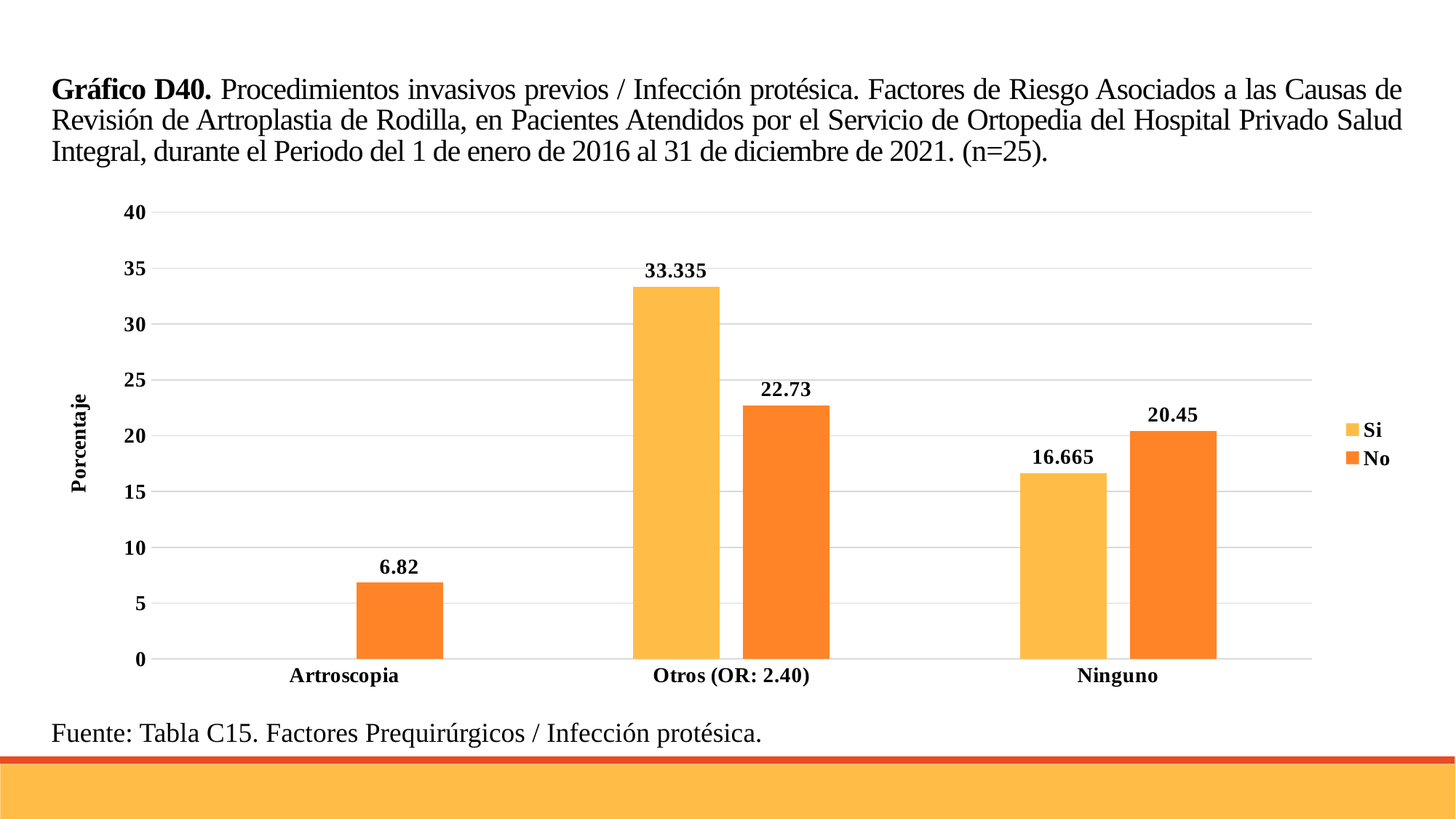
What is the label of the vertical axis? Porcentaje Which category has the lowest value in the "No" series? Artroscopia What kind of chart is shown on the slide? Bar chart What is the difference between the "Si" and "No" values for Otros (OR: 2.40)? 10.605 For Ninguno, which series has the larger value, Si or No? No Which category has the highest value in the "Si" series? Otros (OR: 2.40) What is the value of the "Si" series for Otros (OR: 2.40)? 33.335 What is the value of the "Si" series for Ninguno? 16.665 How many series does the legend list? 2 How many categories are shown on the x axis? 3 What is the value of the "No" series for Artroscopia? 6.82 What is the value of the "No" series for Ninguno? 20.45